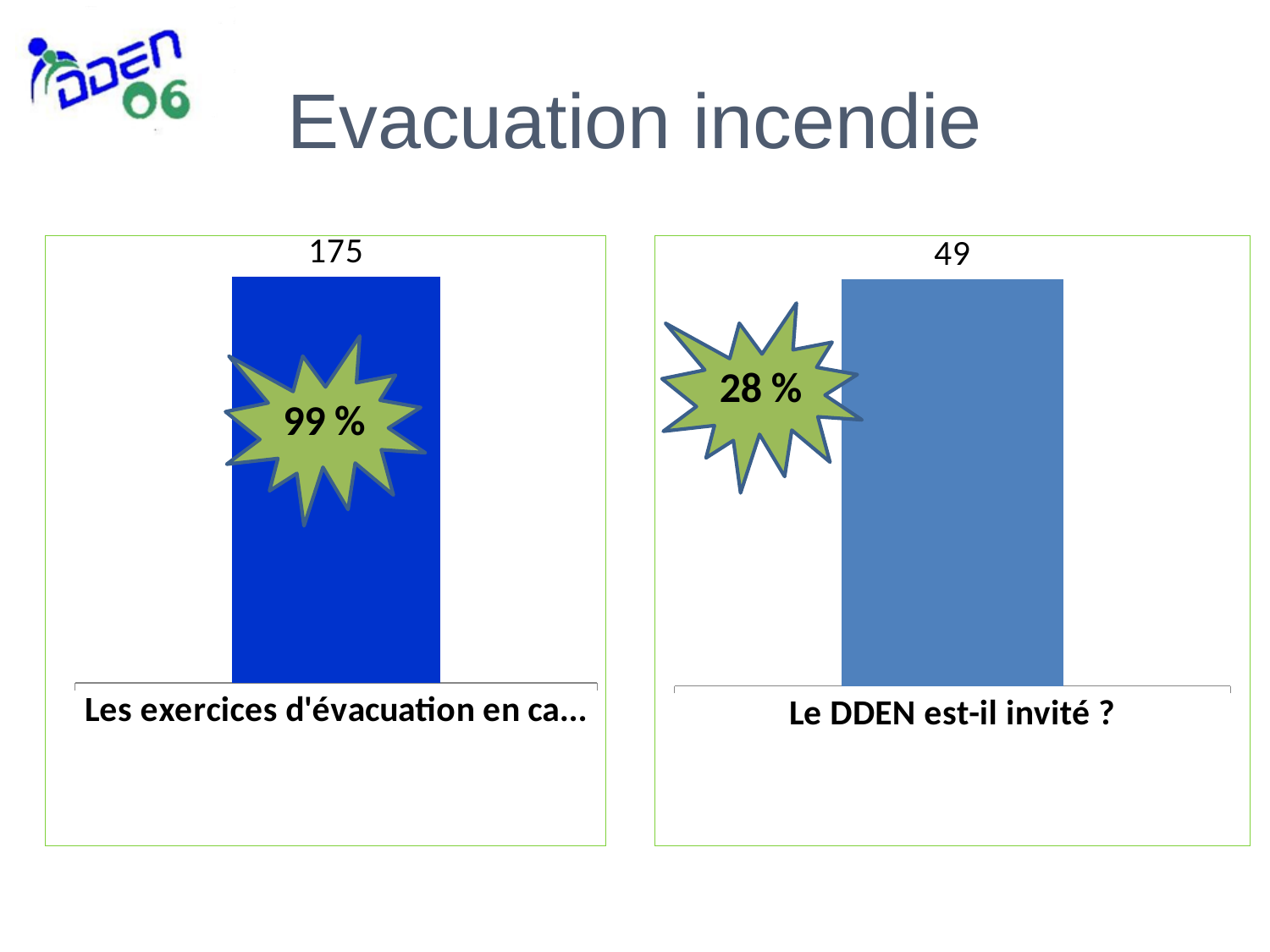
What kind of chart is the left chart? bar chart Which is larger: the bar value in the left chart or the bar value in the right chart? the left chart (175) What kind of chart is the right chart? bar chart In the left chart, what value is shown as the data label on the bar? 175 In the right chart, what is the value for "Le DDEN est-il invité ?"? 49 What percentage is written in the starburst shape on the right chart? 28 % What is the difference between the bar value in the left chart (175) and the bar value in the right chart (49)? 126 How many bars does the left chart contain? 1 What is the category label shown under the bar in the right chart? Le DDEN est-il invité ? How many bars does the right chart contain? 1